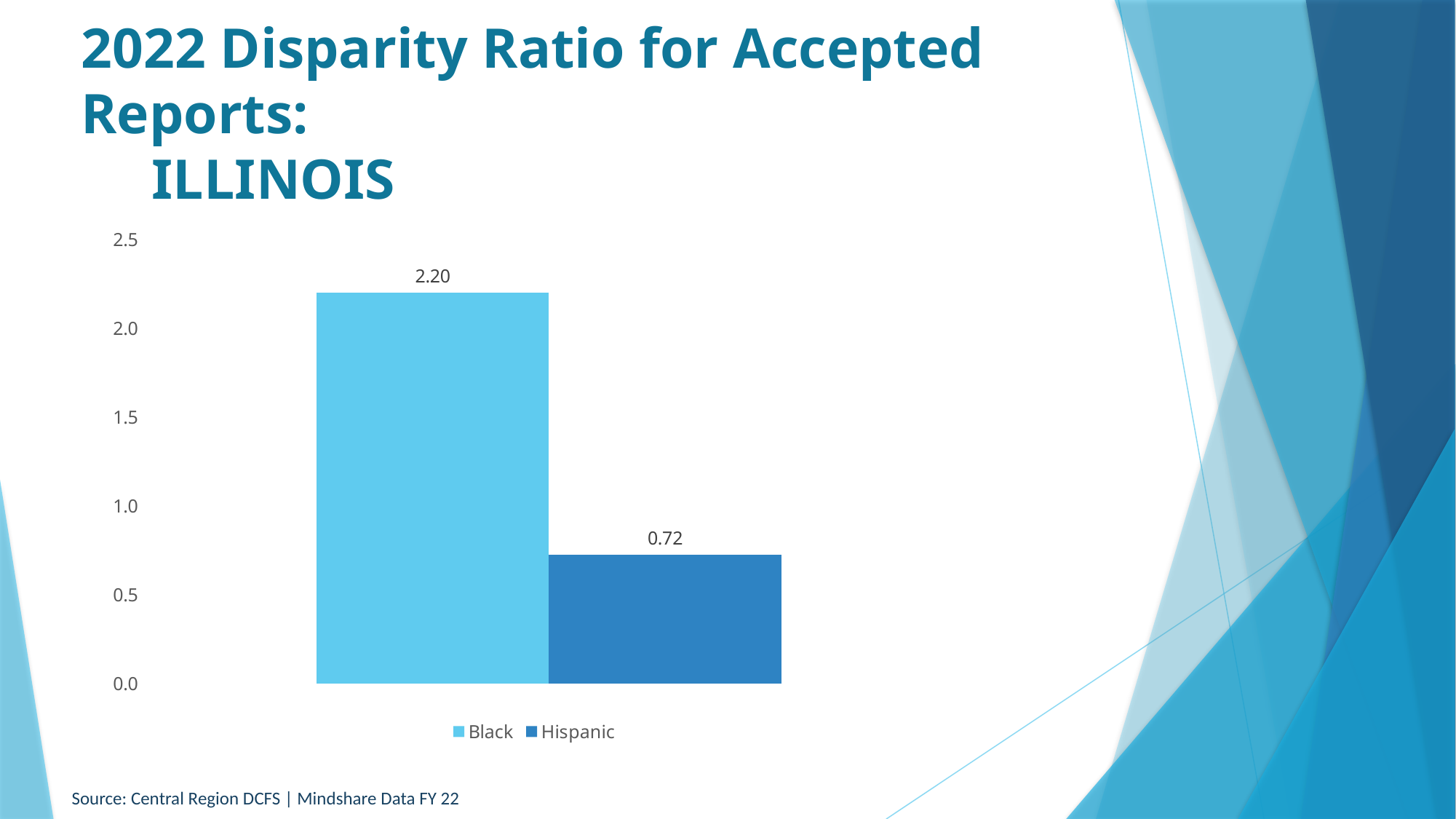
What is the disparity ratio for Hispanic in the chart? 0.72 Which group has the higher disparity ratio? Black Is the value for Black greater or less than 2.0? greater How many bars are plotted in the chart? 2 Is the value for Hispanic greater or less than 1.0? less What is the highest value shown on the vertical axis? 2.5 What is the disparity ratio for Black in the chart? 2.20 What is the difference between the Black and Hispanic disparity ratios? 1.48 Is the disparity ratio for Black larger or smaller than the ratio for Hispanic? larger Which group has the lower disparity ratio? Hispanic How many series does the legend list? 2 What kind of chart is shown on the slide? bar chart